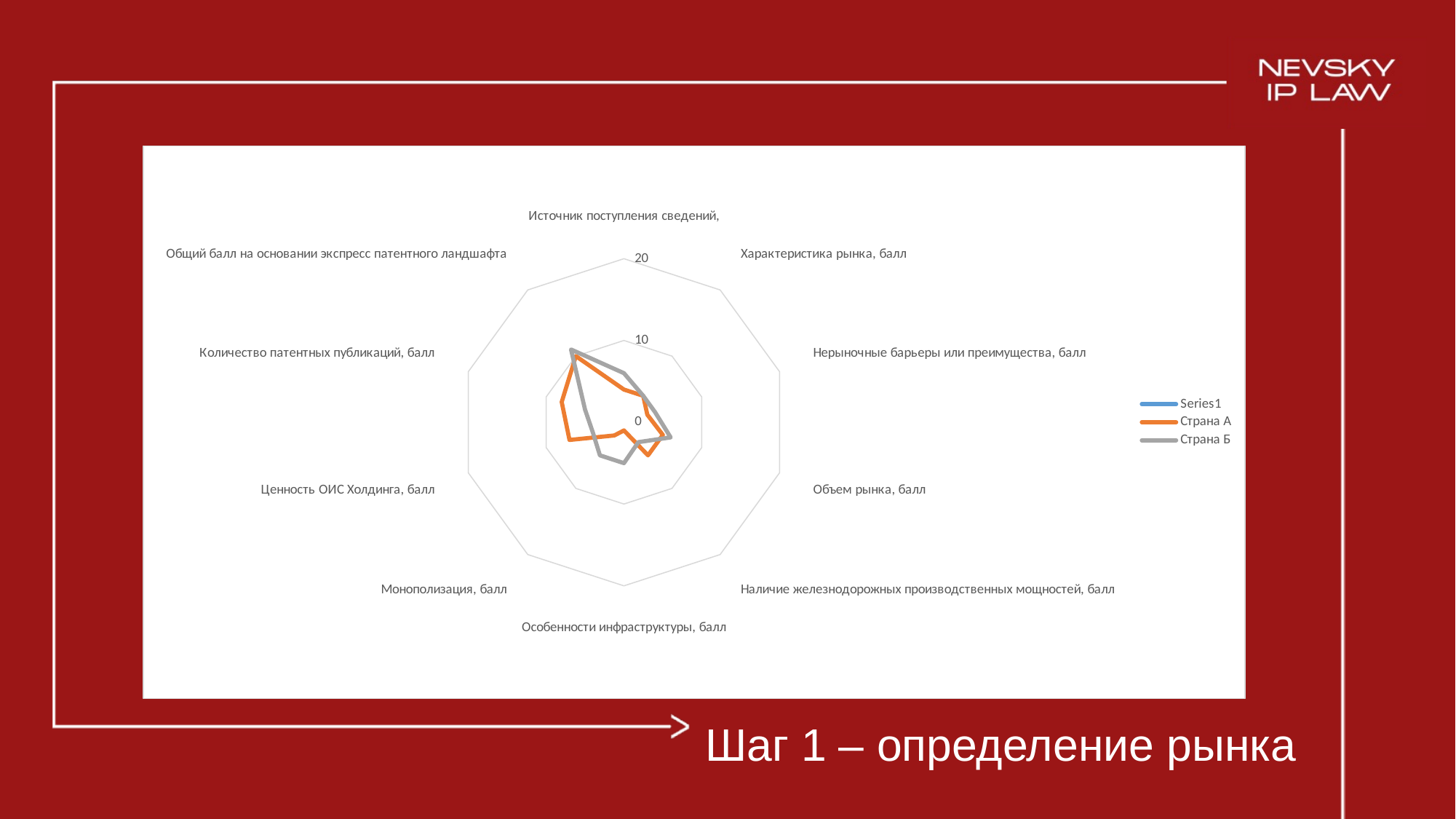
How many categories (axes) does the radar chart have? 10 Is the value for Страна А on Ценность ОИС Холдинга, балл greater or less than 10? less What kind of chart is shown on the slide? Radar chart Is the value for Страна Б on Особенности инфраструктуры, балл greater or less than 10? less Is the value for Страна А on Объем рынка, балл greater or less than 20? less What colour is the line for Страна А? Orange How many series does the legend list? 3 Which series has the larger value on Количество патентных публикаций, балл: Страна А or Страна Б? Страна А What are the series names listed in the legend? Series1, Страна А, Страна Б What is the highest value shown on the radar chart's axis scale? 20